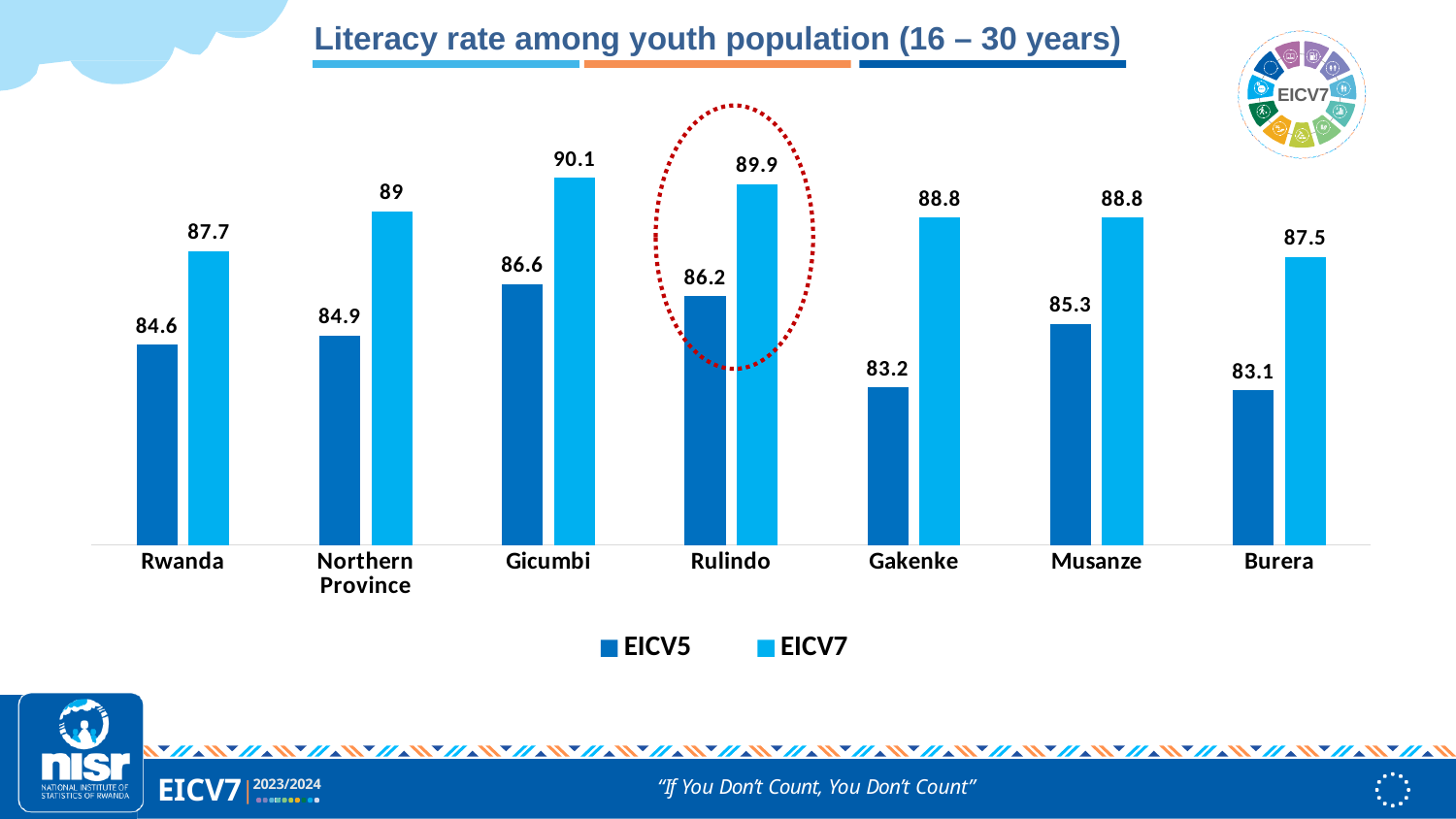
What is the EICV5 literacy rate for Gakenke? 83.2 What is the EICV7 literacy rate for Rulindo? 89.9 What is the title of the chart? Literacy rate among youth population (16 – 30 years) How many categories are shown on the x axis? 7 What kind of chart is shown on the slide? Bar chart Which category has the highest EICV7 value? Gicumbi Which is larger, the EICV5 value for Gicumbi or the EICV5 value for Rulindo? Gicumbi Which category has the lowest EICV5 value? Burera Is the EICV7 value higher than the EICV5 value in every category? Yes What is the difference between the EICV7 and EICV5 values for Gakenke? 5.6 How many series does the legend list? 2 What is the EICV7 value for Northern Province? 89